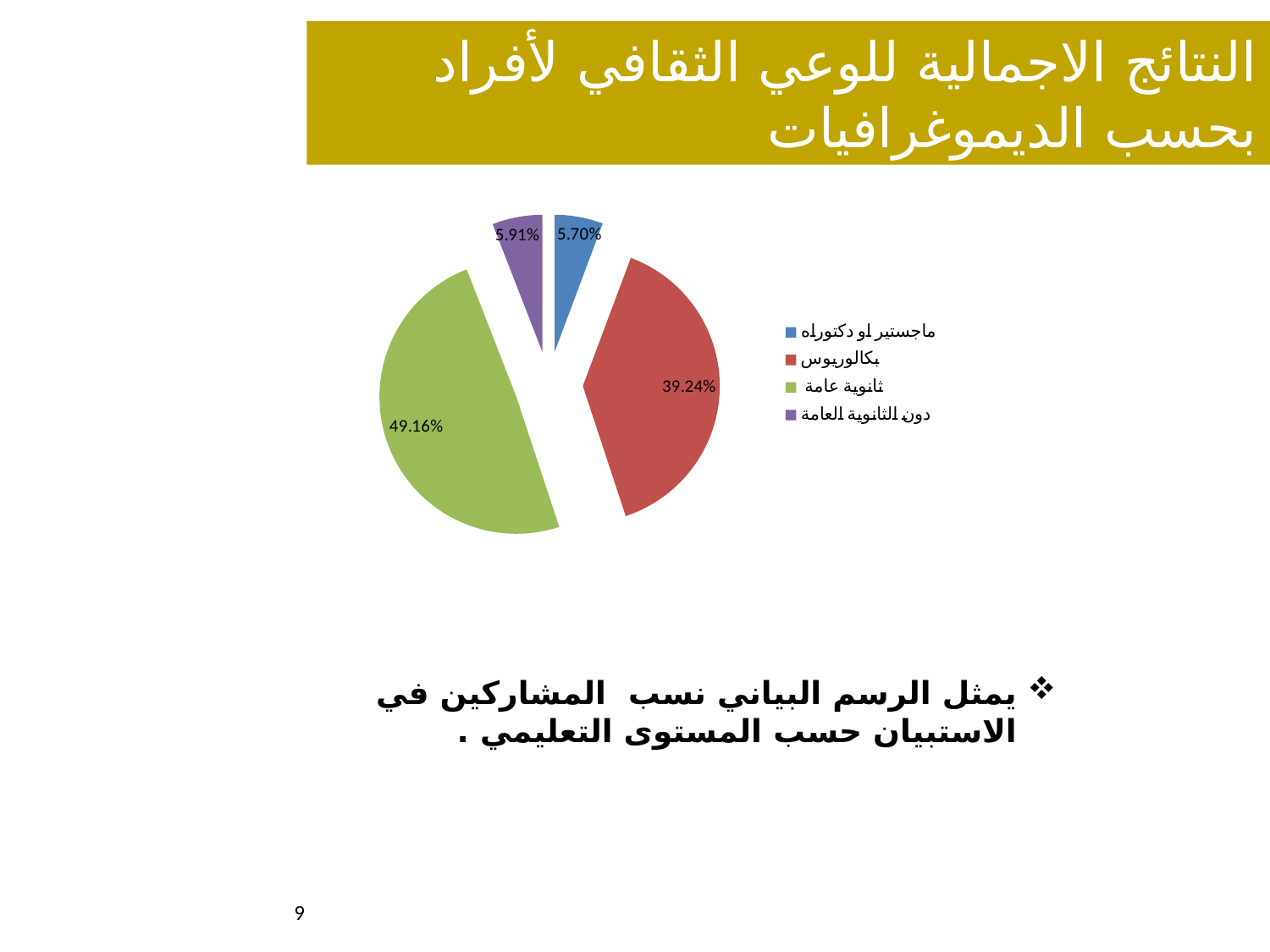
What colour is the slice for ثانوية عامة? Green How many entries does the legend list? 4 How many slices does the pie chart have? 4 What percentage of the pie is labelled for بكالوريوس? 39.24% What percentage of the pie is labelled for ثانوية عامة? 49.16% What percentage of the pie is labelled for ماجستير او دكتوراه? 5.70% What kind of chart is shown on the slide? Pie chart What is the difference in percentage points between ثانوية عامة and بكالوريوس? 9.92 Which category has the largest share of the pie? ثانوية عامة What percentage of the pie is labelled for دون الثانوية العامة? 5.91% Which category has the smallest share of the pie? ماجستير او دكتوراه Which is larger, the share for بكالوريوس or the share for دون الثانوية العامة? بكالوريوس